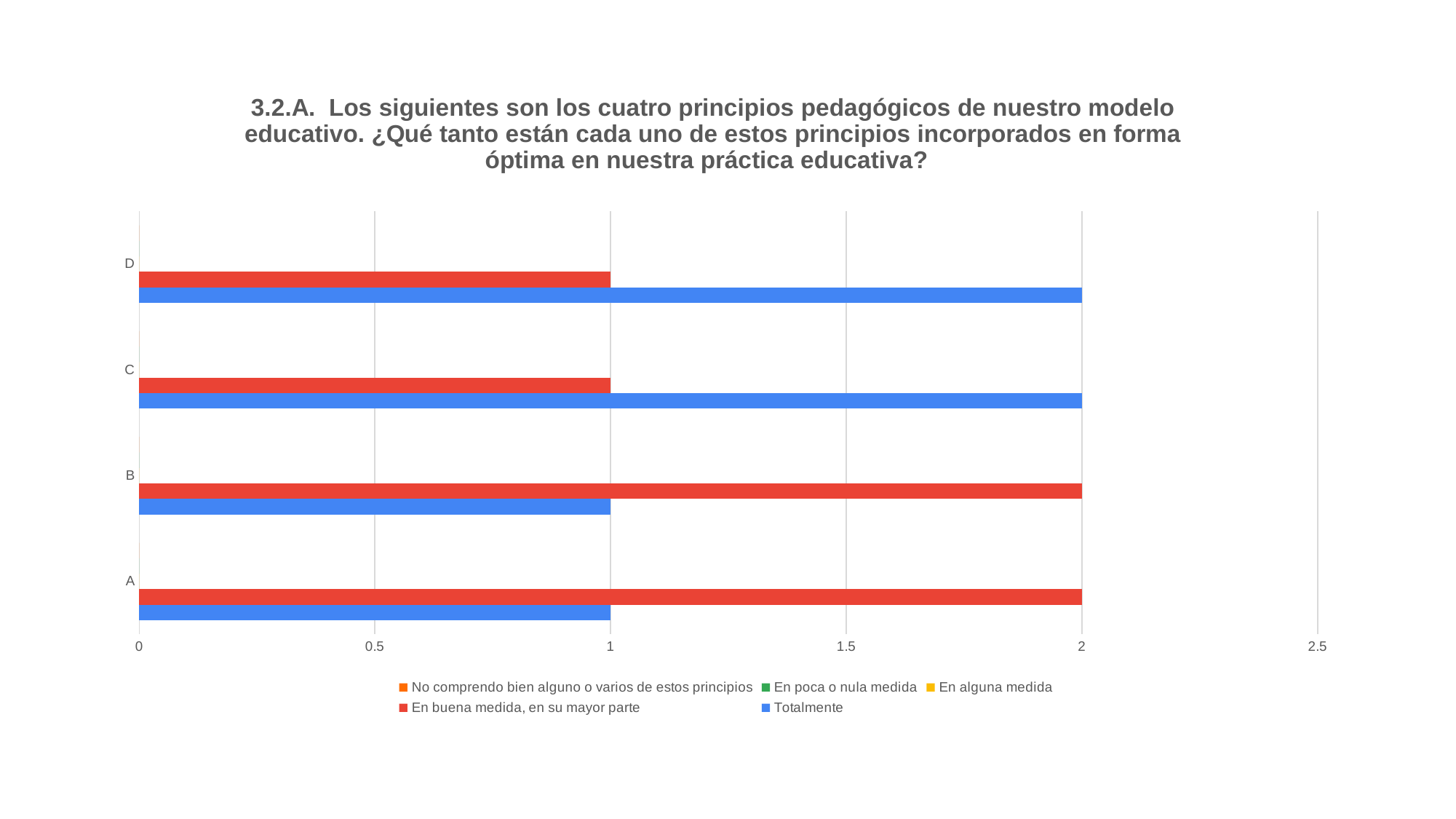
What is the value of the 'Totalmente' series for category D? 2 What is the value of the 'En buena medida, en su mayor parte' series for category C? 1 What kind of chart is shown on the slide? bar chart Which colour represents the 'Totalmente' series in the legend? blue For category D, which series has the larger value: 'Totalmente' or 'En buena medida, en su mayor parte'? Totalmente How many categories are shown on the vertical axis? 4 What is the value of the 'En buena medida, en su mayor parte' series for category A? 2 Is the 'Totalmente' value for category A greater or less than 1.5? less What is the value of the 'Totalmente' series for category B? 1 For category A, which series has the larger value: 'Totalmente' or 'En buena medida, en su mayor parte'? En buena medida, en su mayor parte How many series does the legend list? 5 What is the difference between the 'Totalmente' value and the 'En buena medida, en su mayor parte' value for category C? 1